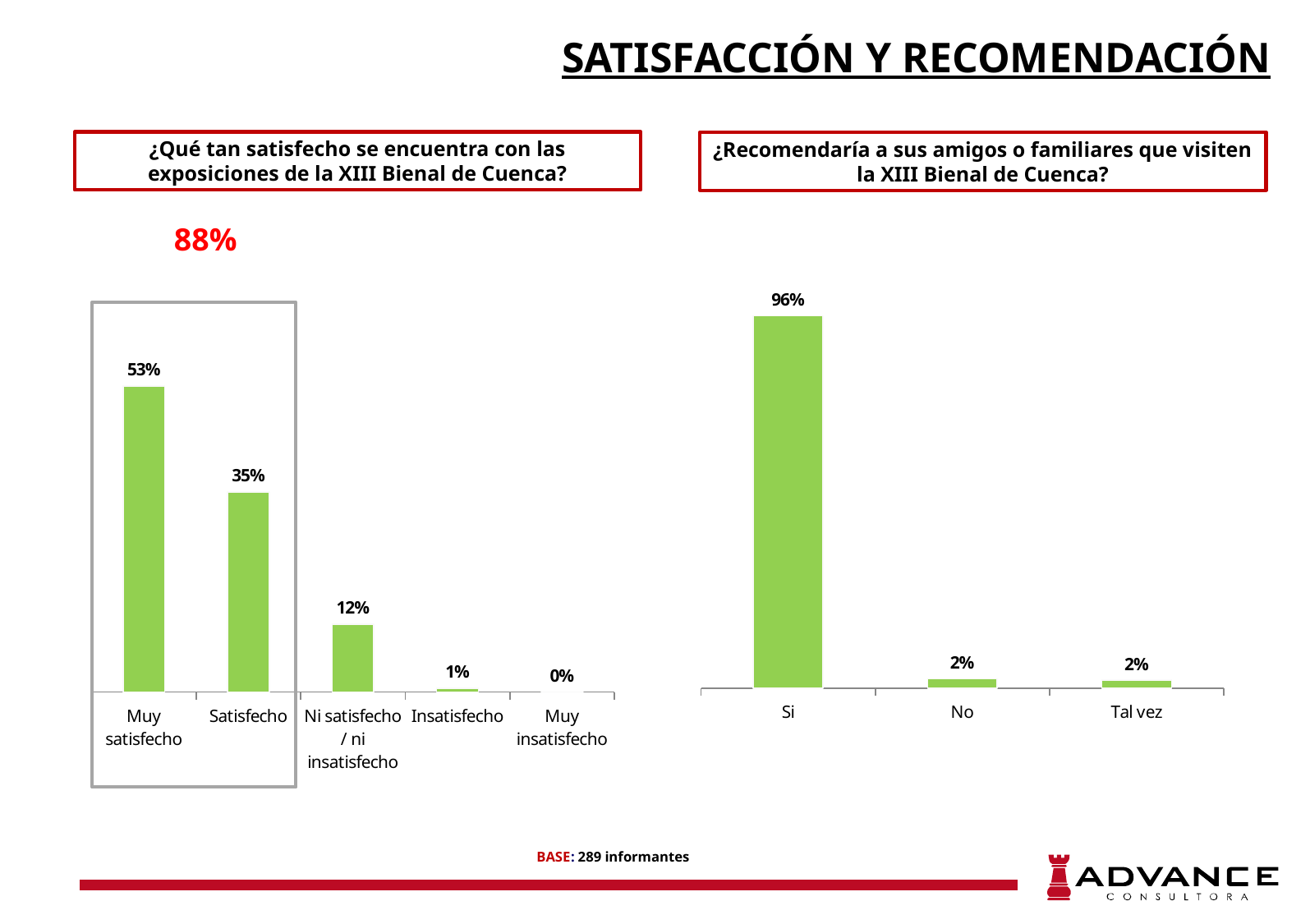
What type of chart is the right chart (recommendation)? Bar chart In the left chart (satisfaction with the exhibitions), what is the value for "Muy satisfecho"? 53% In the right chart (recommendation), what is the value for "Tal vez"? 2% In the left chart (satisfaction with the exhibitions), how many categories are shown? 5 In the left chart (satisfaction with the exhibitions), what is the difference between "Muy satisfecho" and "Satisfecho"? 18% In the left chart (satisfaction with the exhibitions), what combined percentage is highlighted in red above the boxed bars? 88% In the left chart (satisfaction with the exhibitions), what is the value for "Ni satisfecho / ni insatisfecho"? 12% In the right chart (recommendation), how many categories are shown? 3 In the right chart (recommendation), what is the difference between "Si" and "No"? 94% In the left chart (satisfaction with the exhibitions), which category has the lowest value? Muy insatisfecho In the left chart (satisfaction with the exhibitions), which category has the highest value? Muy satisfecho In the right chart (recommendation), what is the value for "Si"? 96%